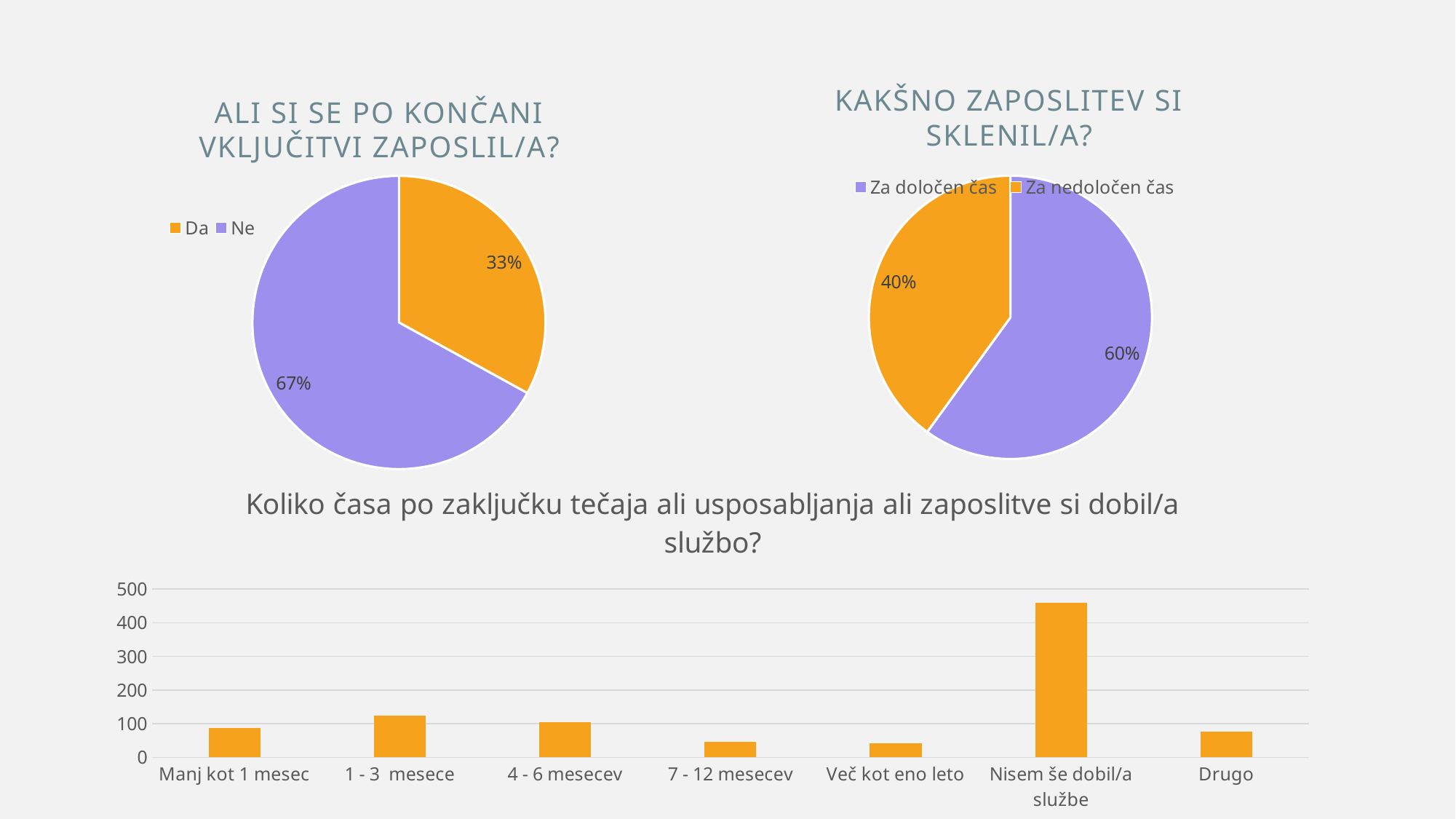
In the pie chart titled 'ALI SI SE PO KONČANI VKLJUČITVI ZAPOSLIL/A?', which slice is larger, 'Da' or 'Ne'? Ne In the bar chart at the bottom of the slide, how many categories are shown on the x axis? 7 In the bar chart at the bottom of the slide, which category has the highest value? Nisem še dobil/a službe In the pie chart titled 'KAKŠNO ZAPOSLITEV SI SKLENIL/A?', what share is labelled for 'Za določen čas'? 60% In the pie chart titled 'ALI SI SE PO KONČANI VKLJUČITVI ZAPOSLIL/A?', what share is labelled for 'Ne'? 67% What kind of chart is the chart at the bottom of the slide titled 'Koliko časa po zaključku tečaja ali usposabljanja ali zaposlitve si dobil/a službo?'? bar chart In the bar chart at the bottom of the slide, is the value for '7 - 12 mesecev' greater or less than 100? less In the pie chart titled 'KAKŠNO ZAPOSLITEV SI SKLENIL/A?', what share is labelled for 'Za nedoločen čas'? 40% In the bar chart at the bottom of the slide, is the value for 'Nisem še dobil/a službe' greater or less than 400? greater In the pie chart titled 'KAKŠNO ZAPOSLITEV SI SKLENIL/A?', how many entries does the legend list? 2 In the pie chart titled 'KAKŠNO ZAPOSLITEV SI SKLENIL/A?', what is the difference in percentage points between 'Za določen čas' and 'Za nedoločen čas'? 20